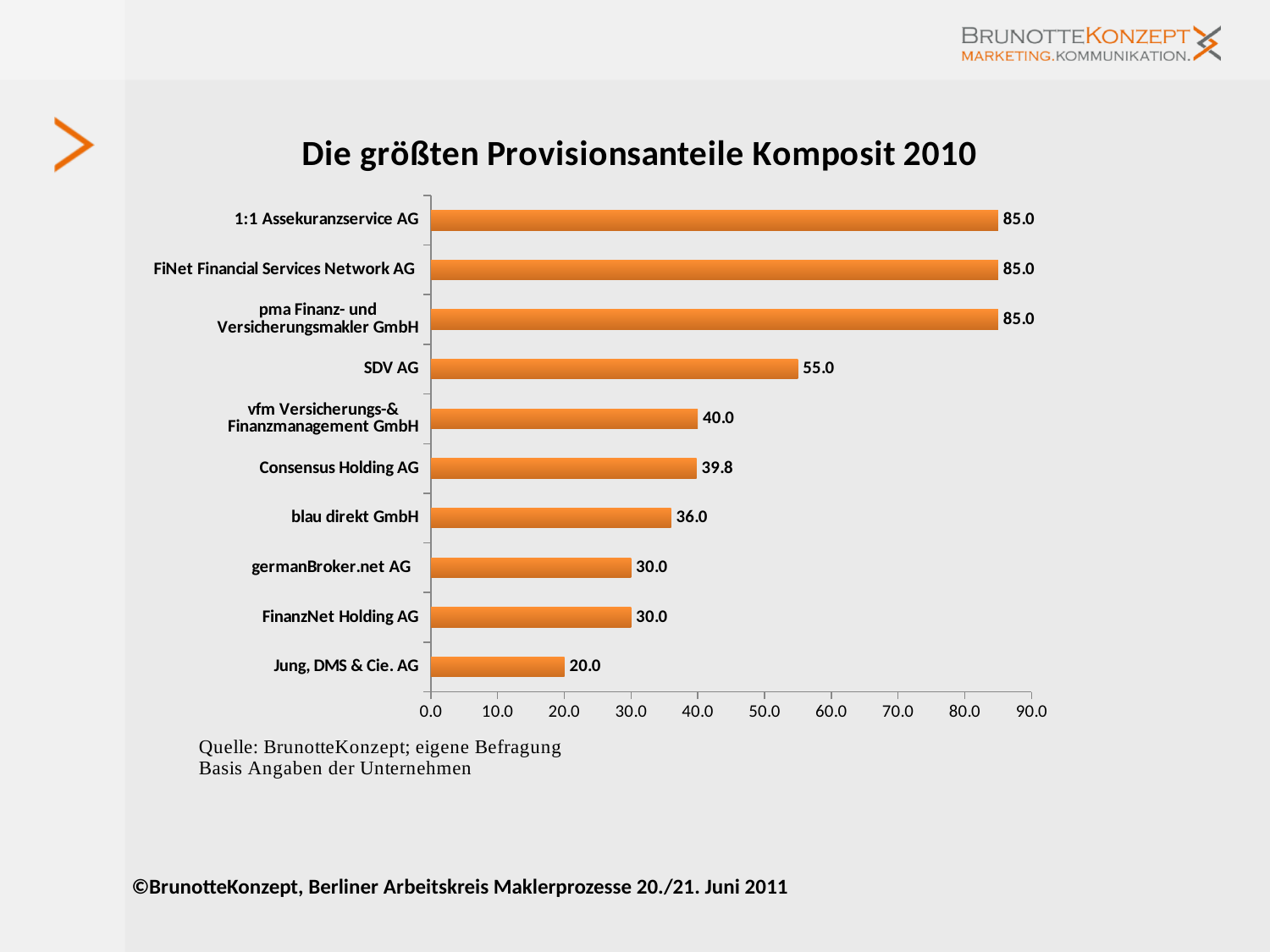
What is the difference between the values for 1:1 Assekuranzservice AG and Jung, DMS & Cie. AG? 65.0 How many companies are shown in the chart? 10 What is the value for SDV AG? 55.0 What is the value for Jung, DMS & Cie. AG? 20.0 Which company has the lowest value? Jung, DMS & Cie. AG What is the value for Consensus Holding AG? 39.8 Which is larger, the value for SDV AG or the value for blau direkt GmbH? SDV AG What is the title of the chart? Die größten Provisionsanteile Komposit 2010 Is the value for germanBroker.net AG greater or less than 40.0? less What is the difference between the values for SDV AG and vfm Versicherungs-& Finanzmanagement GmbH? 15.0 What kind of chart is shown on the slide? bar chart What is the value for blau direkt GmbH? 36.0